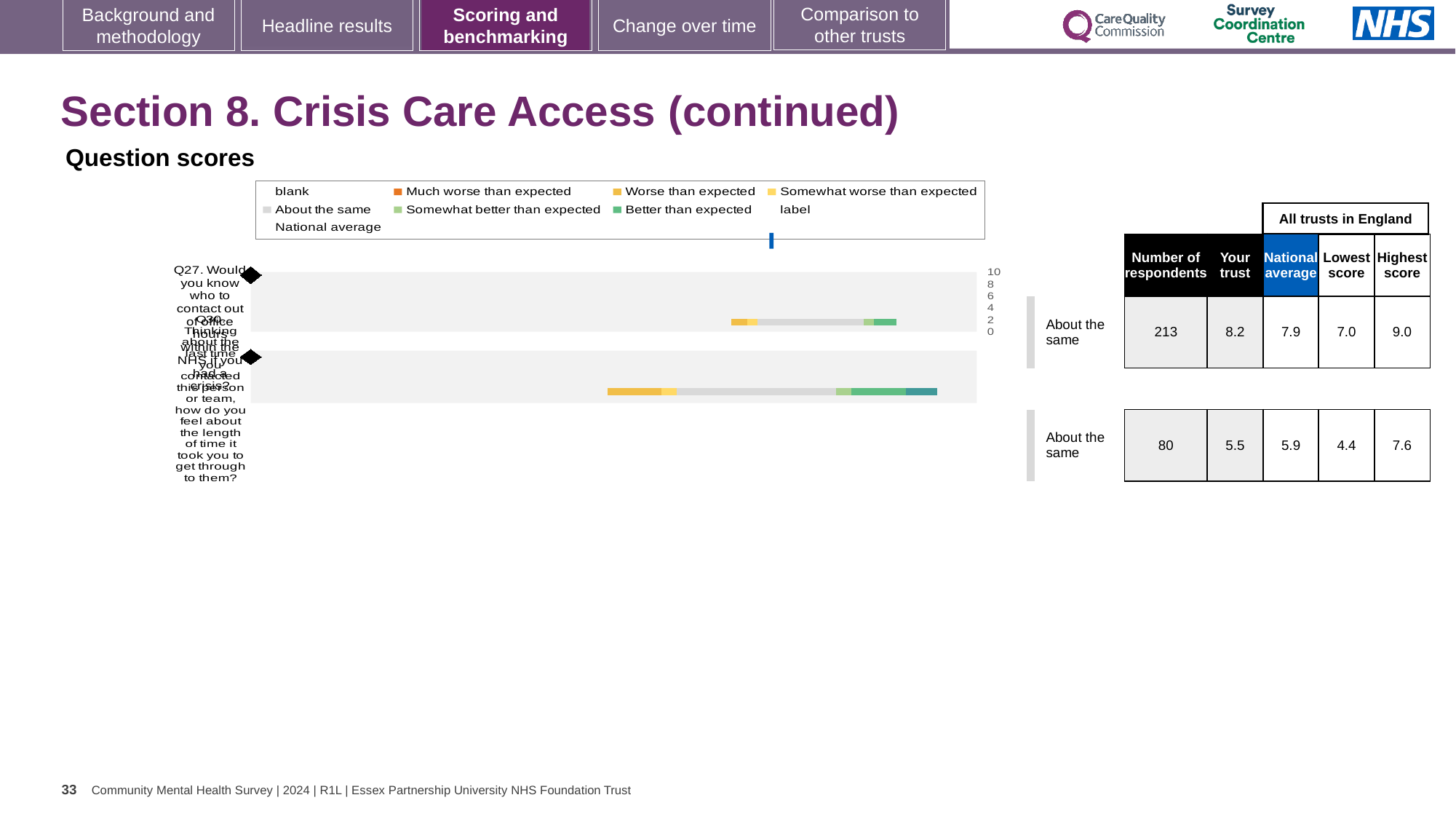
How many survey questions are plotted in the question scores chart? 2 What is the national average score for Q27? 7.9 What is the highest score among all trusts in England for Q27? 9.0 What kind of chart is used to show the question scores on this slide? bar chart What is the lowest score among all trusts in England for Q30? 4.4 Which question has more respondents, Q27 or Q30? Q27 What is the difference between the national average and the 'Your trust' score for Q30? 0.4 What is the difference between the highest score and the lowest score for Q27? 2.0 What is the number of respondents for Q27 in the question scores table? 213 What benchmark category is shown next to the bars for both Q27 and Q30? About the same What is the 'Your trust' score for Q30? 5.5 For Q27, which is larger: the 'Your trust' score or the national average? Your trust